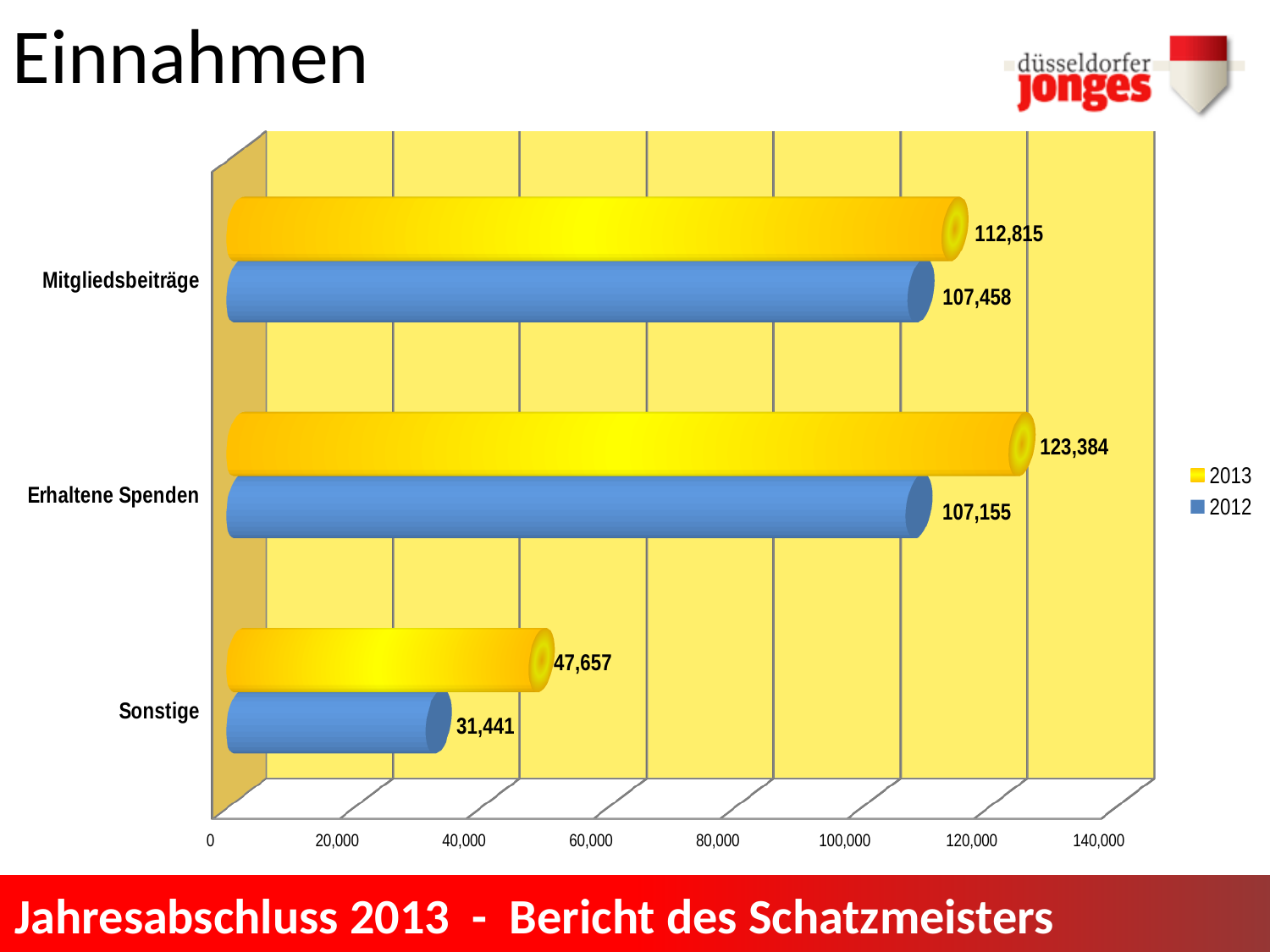
How many categories are shown on the chart? 3 What is the value for Mitgliedsbeiträge in 2013? 112,815 What is the value for Erhaltene Spenden in 2012? 107,155 Which is larger for Sonstige: the 2013 value or the 2012 value? 2013 What is the value for Sonstige in 2013? 47,657 Which category has the highest value in 2013? Erhaltene Spenden What kind of chart is shown on the slide? Bar chart What is the value for Sonstige in 2012? 31,441 What is the difference between the 2013 and 2012 values for Mitgliedsbeiträge? 5,357 Which category has the lowest value in 2012? Sonstige What is the difference between the 2013 and 2012 values for Erhaltene Spenden? 16,229 How many series does the legend list? 2